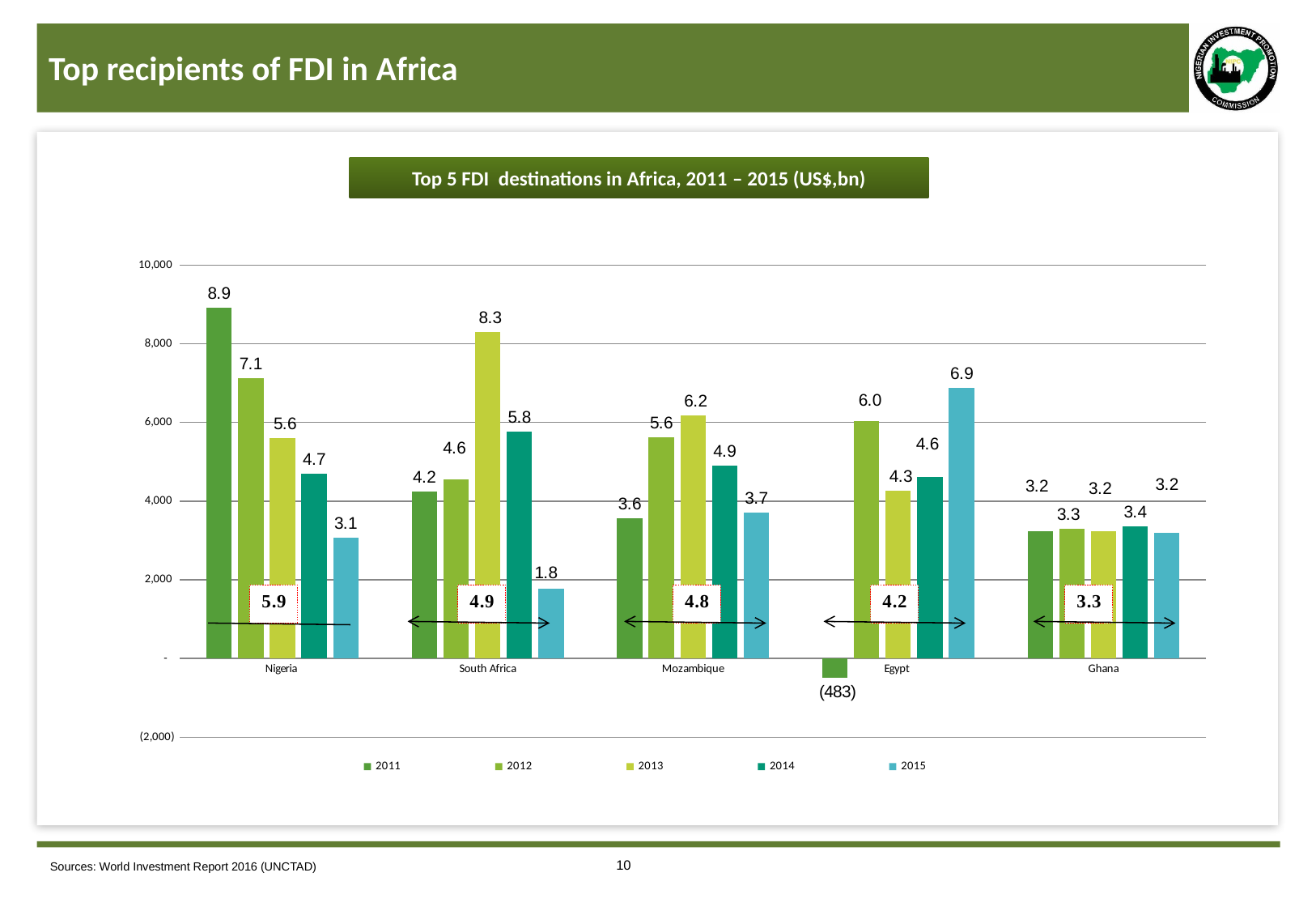
What is the difference between Nigeria's 2011 value and its 2015 value? 5.9 Do Nigeria's values rise or fall from 2011 to 2015? Fall What kind of chart is shown on the slide? Bar chart What is the value for Egypt in 2015? 6.9 Which is larger: Mozambique in 2013 or Egypt in 2013? Mozambique in 2013 What is the value for South Africa in 2013? 8.3 Which country has the highest value in 2011? Nigeria What is the value for Nigeria in 2011? 8.9 How many countries are shown on the x axis? 5 How many series does the legend list? 5 Which country has the lowest value in 2015? South Africa What is the title of the chart? Top 5 FDI destinations in Africa, 2011 – 2015 (US$,bn)